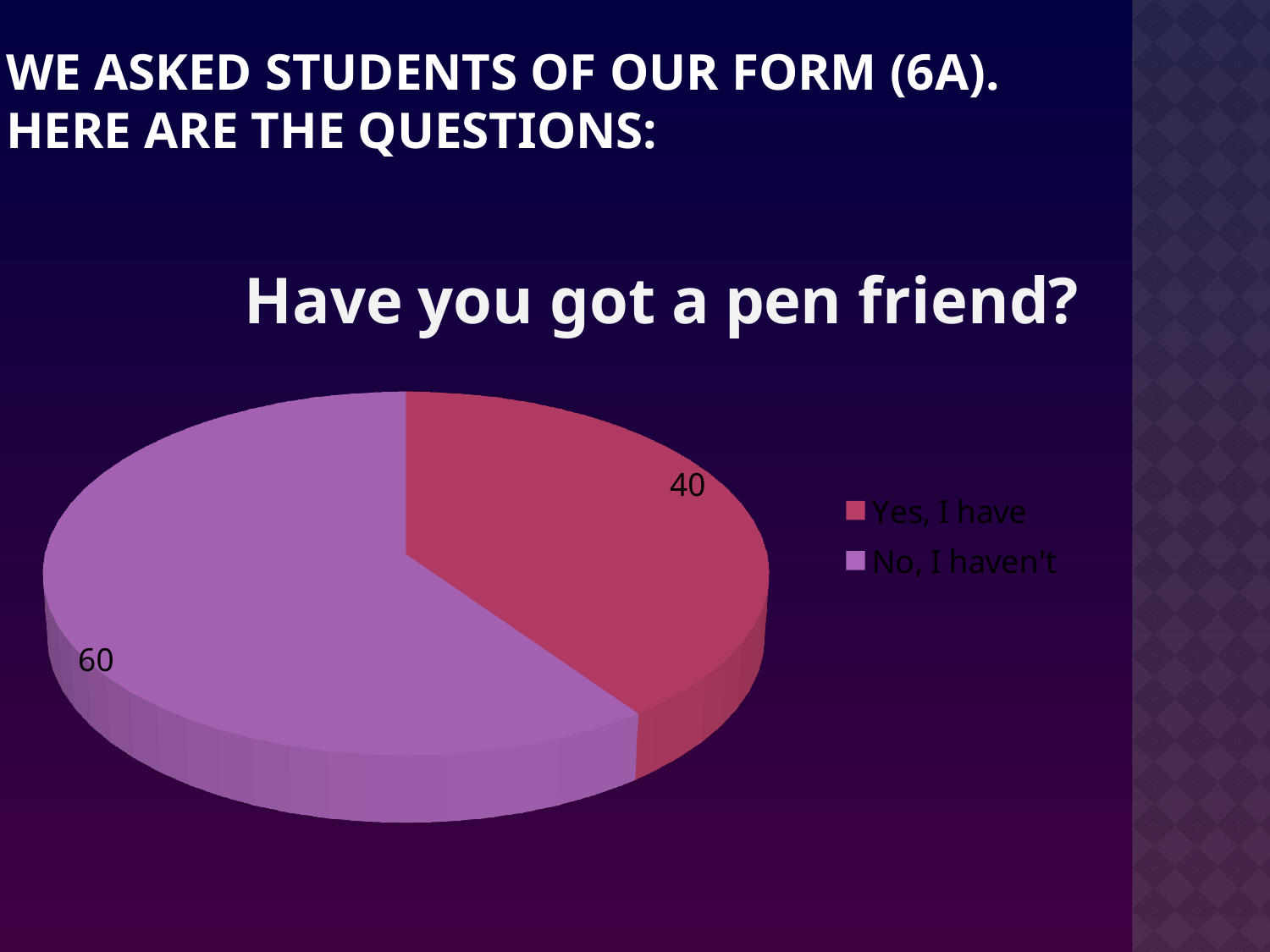
Which category has the largest slice of the pie? No, I haven't What colour is the "Yes, I have" slice? Red What share of the pie does the "No, I haven't" slice represent? 60% What kind of chart is shown on the slide? Pie chart Which category has the smallest slice of the pie? Yes, I have What share of the pie does the "Yes, I have" slice represent? 40% What is the title of the chart? Have you got a pen friend? How many categories does the pie chart show? 2 What is the value for "Yes, I have"? 40 What is the value for "No, I haven't"? 60 Which is larger, the value for "Yes, I have" or the value for "No, I haven't"? No, I haven't What is the difference between the values for "No, I haven't" and "Yes, I have"? 20